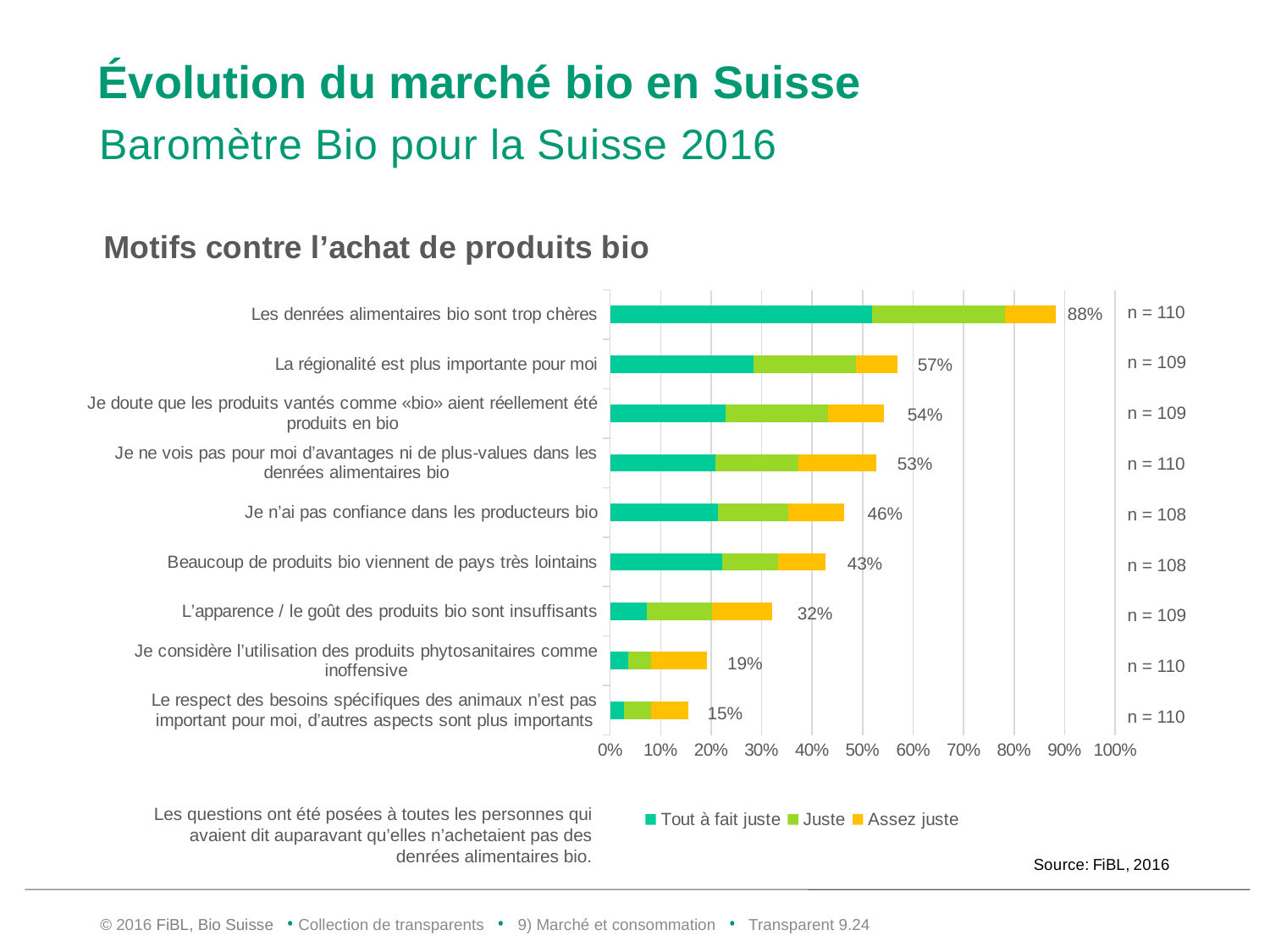
How many series does the legend list? 3 Is the total for "Je doute que les produits vantés comme «bio» aient réellement été produits en bio" greater or less than 50%? greater What is the sample size (n) shown for "Je n'ai pas confiance dans les producteurs bio"? n = 108 Which motif has the highest total percentage? Les denrées alimentaires bio sont trop chères Which has a larger total: "Beaucoup de produits bio viennent de pays très lointains" or "Je considère l'utilisation des produits phytosanitaires comme inoffensive"? Beaucoup de produits bio viennent de pays très lointains What is the total percentage shown for "Je n'ai pas confiance dans les producteurs bio"? 46% How many motifs (categories) are plotted in the chart? 9 What is the total percentage shown for "L'apparence / le goût des produits bio sont insuffisants"? 32% What is the difference between the total for "Les denrées alimentaires bio sont trop chères" and the total for "La régionalité est plus importante pour moi"? 31% Which motif has the lowest total percentage? Le respect des besoins spécifiques des animaux n'est pas important pour moi, d'autres aspects sont plus importants What kind of chart is shown on the slide? Stacked bar chart What is the total percentage shown for "Les denrées alimentaires bio sont trop chères"? 88%